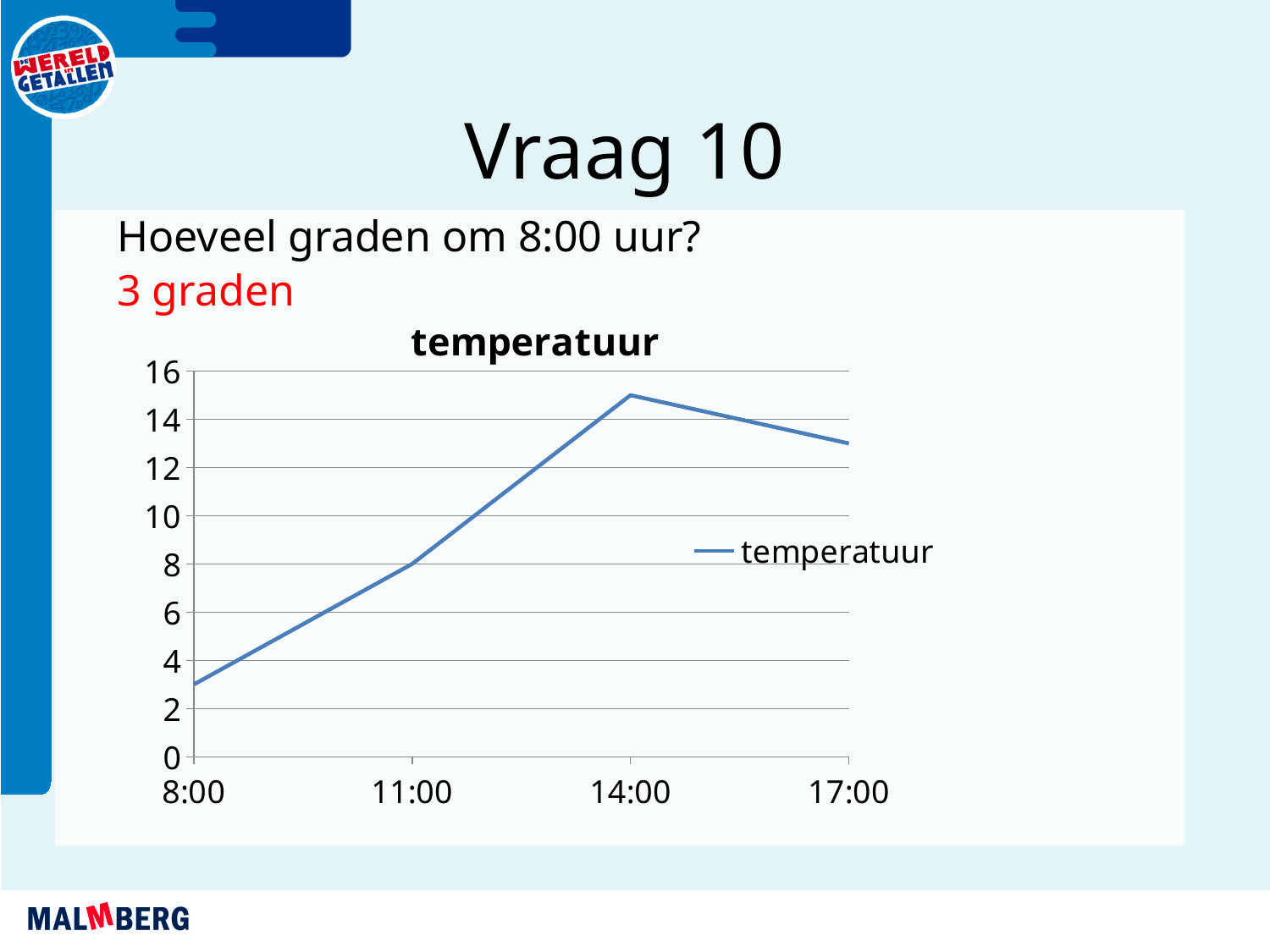
How many series does the legend list? 1 At which time is the temperature lowest? 8:00 How much higher is the temperature at 11:00 than at 8:00? 5 What is the temperature at 8:00 according to the chart? 3 Is the temperature at 17:00 greater or less than 14? less What kind of chart is shown on the slide? line chart Does the temperature rise or fall between 14:00 and 17:00? fall Which is higher, the temperature at 14:00 or at 17:00? 14:00 Is the temperature at 14:00 greater or less than 14? greater What is the temperature at 11:00 according to the chart? 8 At which time is the temperature highest? 14:00 How many time points are plotted on the chart? 4